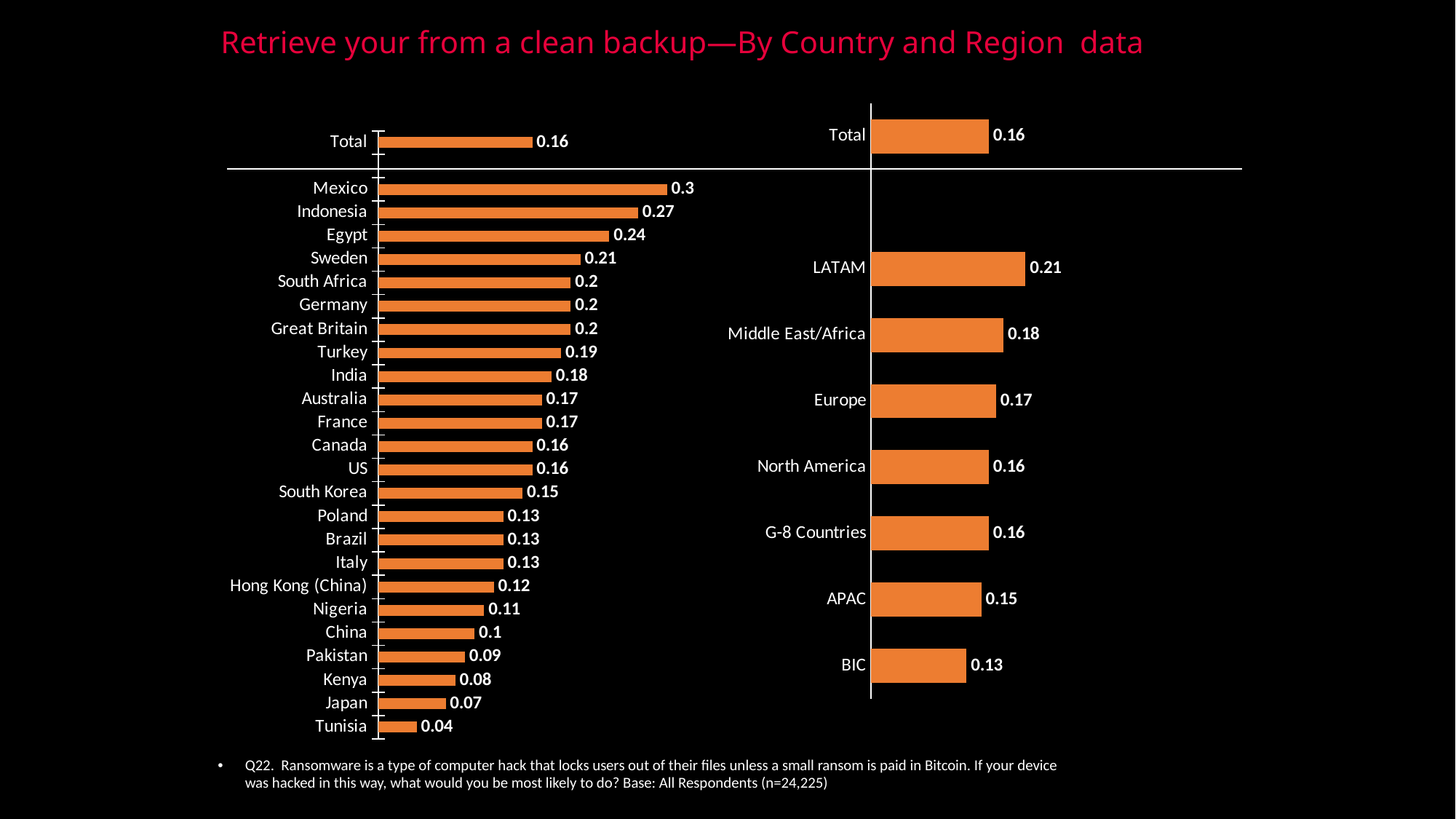
In the right chart (by region), how many regions are listed below the Total bar? 7 What type of chart is used on this slide? Bar chart In the left chart (by country), which has the larger value, Sweden or Turkey? Sweden In the right chart (by region), what is the value for LATAM? 0.21 In the left chart (by country), what is the value for Japan? 0.07 In the left chart (by country), what is the value for Mexico? 0.3 In the right chart (by region), which region has the lowest value? BIC In the left chart (by country), which country has the highest value? Mexico In the right chart (by region), what is the difference between the values for Middle East/Africa and APAC? 0.03 In the left chart (by country), how many countries are listed below the Total bar? 24 In the left chart (by country), which country has the lowest value? Tunisia In the left chart (by country), what is the difference between the values for Indonesia and Egypt? 0.03